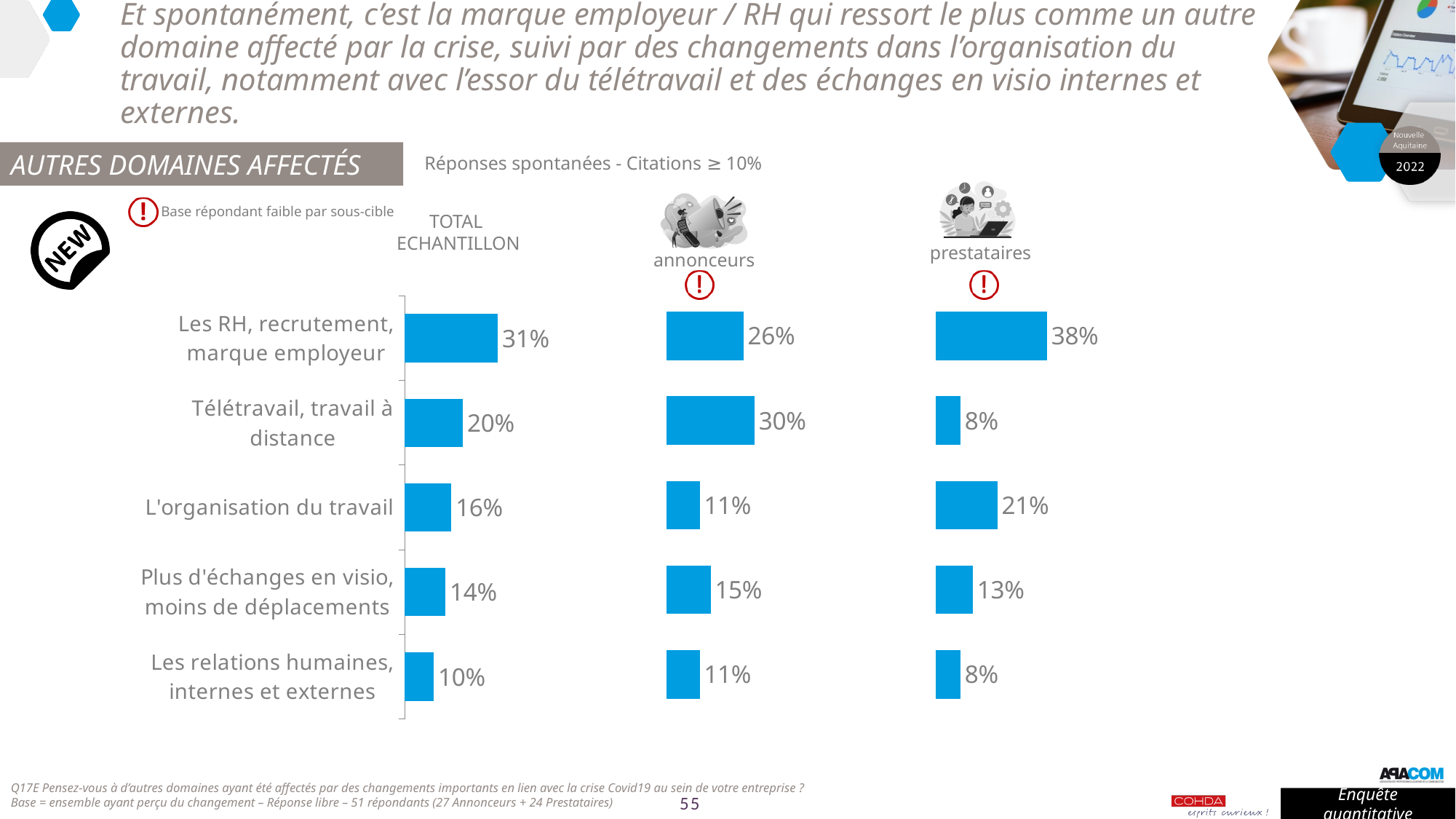
How many categories are shown in the TOTAL ECHANTILLON chart? 5 In the annonceurs chart, which category has the highest value? Télétravail, travail à distance What kind of chart is used for the TOTAL ECHANTILLON data? Bar chart In the TOTAL ECHANTILLON chart, do the values rise or fall from the top category to the bottom category? Fall In the prestataires chart, what is the value for "Plus d'échanges en visio, moins de déplacements"? 13% For "Télétravail, travail à distance", which is larger: the annonceurs value or the prestataires value? annonceurs In the prestataires chart, which category has the highest value? Les RH, recrutement, marque employeur In the TOTAL ECHANTILLON chart, which category has the lowest value? Les relations humaines, internes et externes In the prestataires chart, what is the value for "L'organisation du travail"? 21% In the TOTAL ECHANTILLON chart, what is the value for "Les RH, recrutement, marque employeur"? 31% What is the difference between the prestataires value and the annonceurs value for "Les RH, recrutement, marque employeur"? 12 percentage points In the annonceurs chart, what is the value for "Télétravail, travail à distance"? 30%